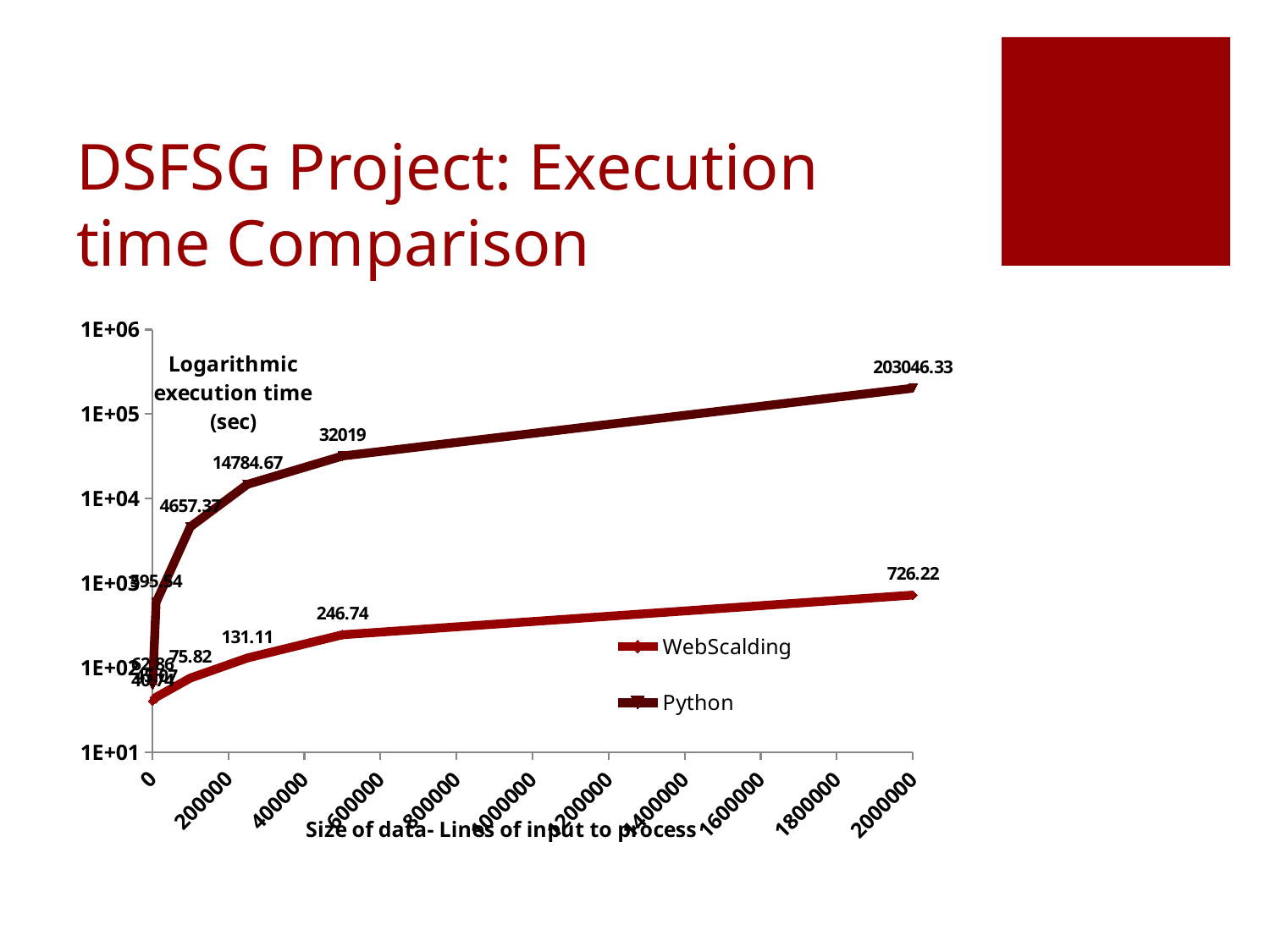
What is the Python value at the data size where WebScalding is labeled 246.74? 32019 What is the difference between the Python and WebScalding execution times at 2000000 lines of input? 202320.11 What is the highest labeled value for the WebScalding series? 726.22 What kind of chart is shown on the slide? line chart Which series has the higher execution time at 2000000 lines of input, Python or WebScalding? Python What is the WebScalding execution time at 2000000 lines of input? 726.22 Is the Python execution time at 2000000 lines of input greater or less than 1E+05? greater Which two series are listed in the legend? WebScalding and Python What is the Python execution time at 2000000 lines of input? 203046.33 What is the title of the x axis? Size of data- Lines of input to process How many series does the legend list? 2 Do the execution times rise or fall as the size of data increases? rise